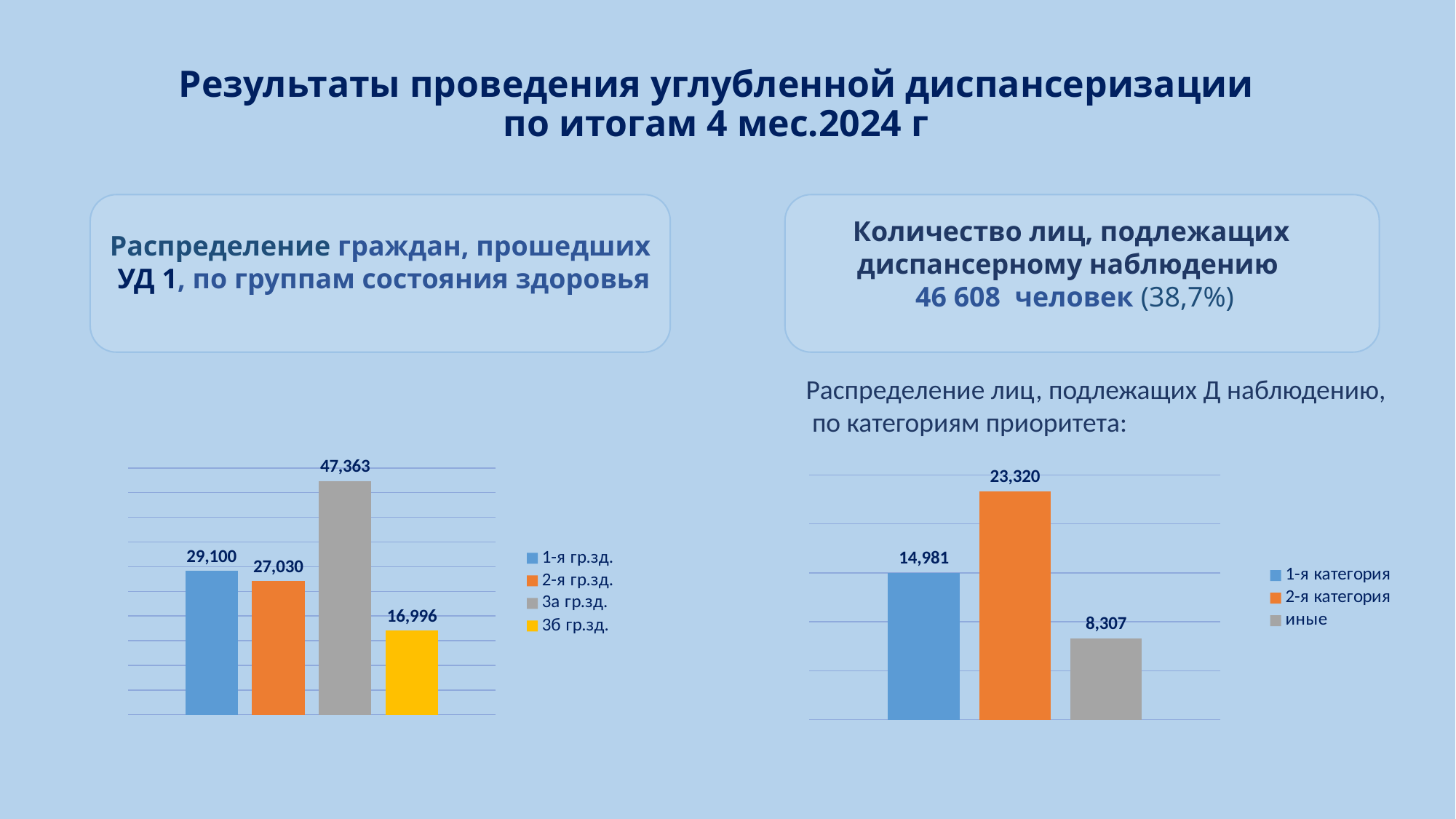
In the right chart, what is the value for 1-я категория? 14,981 What type of chart is the right chart? bar chart In the right chart, which category has the highest value? 2-я категория In the left chart, what is the difference between the values for 3а гр.зд. and 3б гр.зд.? 30,367 In the left chart, which is larger: the value for 1-я гр.зд. or 2-я гр.зд.? 1-я гр.зд. In the right chart, what is the difference between the values for 2-я категория and 1-я категория? 8,339 How many entries does the legend of the left chart list? 4 In the left chart, which group has the highest value? 3а гр.зд. In the left chart, what is the value for 3а гр.зд.? 47,363 In the left chart, what is the value for 2-я гр.зд.? 27,030 In the right chart, what is the value for иные? 8,307 In the left chart, which group has the lowest value? 3б гр.зд.